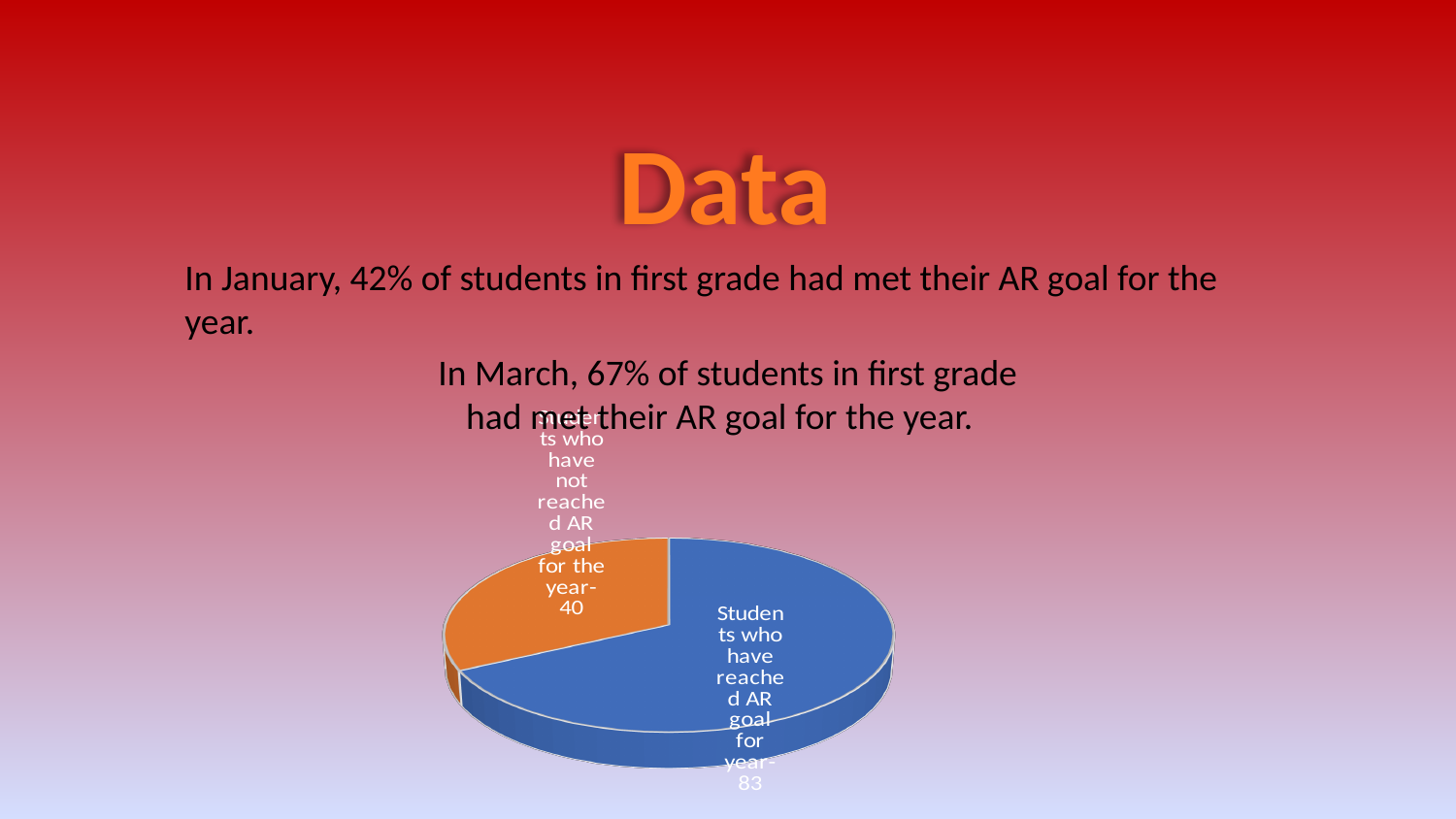
What is the total number of students represented in the pie chart? 123 Which is larger: the number of students who have reached their AR goal or the number who have not? Students who have reached AR goal for year Which slice of the pie chart is the largest? Students who have reached AR goal for year Which slice of the pie chart is the smallest? Students who have not reached AR goal for the year How many slices does the pie chart have? 2 What is the value for students who have reached their AR goal for the year? 83 What is the value for students who have not reached their AR goal for the year? 40 What colour is the slice for students who have reached their AR goal? blue What type of chart is shown on the slide? pie chart What colour is the slice for students who have not reached their AR goal? orange What is the difference between the number of students who have reached their AR goal and those who have not? 43 What share of the pie do students who have reached their AR goal represent? 67%